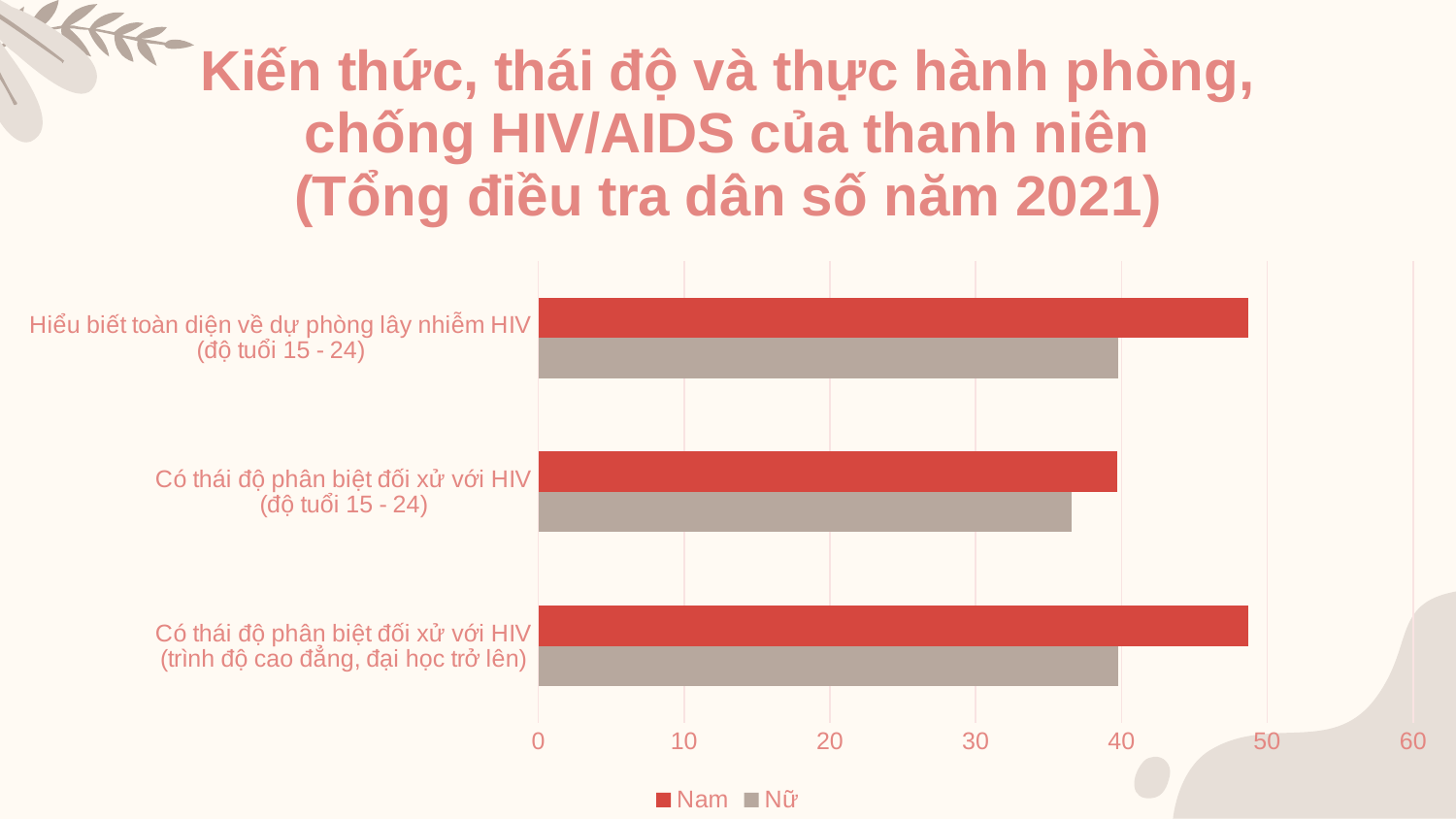
How many categories are plotted on the chart? 3 Is the Nam value for "Có thái độ phân biệt đối xử với HIV (trình độ cao đẳng, đại học trở lên)" greater or less than 50? less Which category has the lowest Nam value? Có thái độ phân biệt đối xử với HIV (độ tuổi 15 - 24) For "Có thái độ phân biệt đối xử với HIV (trình độ cao đẳng, đại học trở lên)", which is larger, Nam or Nữ? Nam What kind of chart is shown on the slide? bar chart Is the Nữ value for "Hiểu biết toàn diện về dự phòng lây nhiễm HIV (độ tuổi 15 - 24)" greater or less than 30? greater For "Hiểu biết toàn diện về dự phòng lây nhiễm HIV (độ tuổi 15 - 24)", which is larger, Nam or Nữ? Nam How many series does the legend list? 2 What are the two series named in the legend? Nam and Nữ Which colour represents the Nam series? red Is the Nam value for "Hiểu biết toàn diện về dự phòng lây nhiễm HIV (độ tuổi 15 - 24)" greater or less than 40? greater